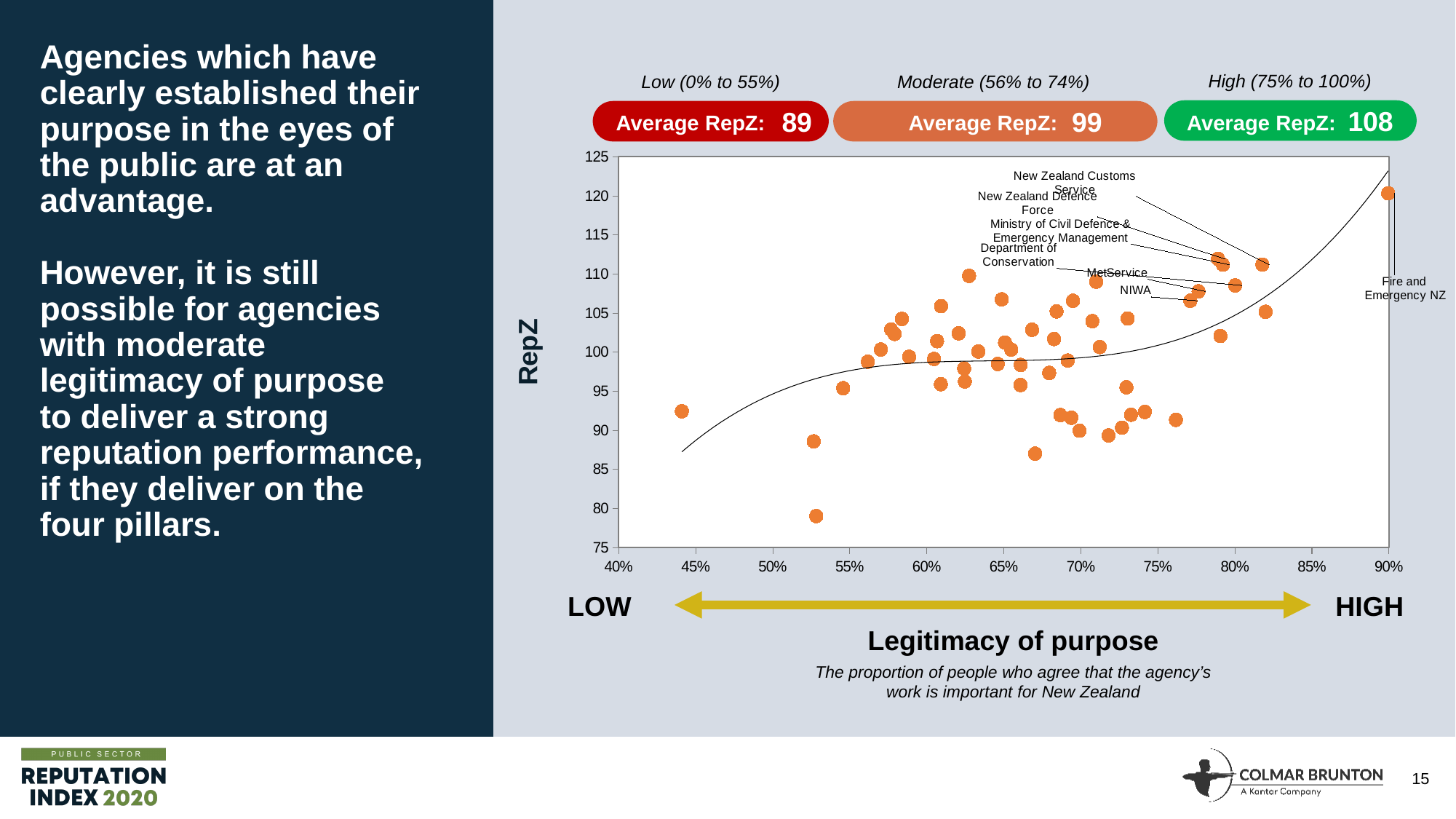
What kind of chart is shown on the slide? scatter chart What is the label on the vertical axis of the chart? RepZ Does RepZ generally rise or fall as legitimacy of purpose increases along the x axis? rise Which is larger, the Average RepZ of the Moderate band or the Low band? Moderate band What is the difference between the Average RepZ of the High band and the Low band? 19 Which legitimacy band has the highest Average RepZ? High (75% to 100%) What is the Average RepZ for the Moderate (56% to 74%) legitimacy band? 99 What is the Average RepZ for the High (75% to 100%) legitimacy band? 108 Is the RepZ value for Fire and Emergency NZ greater or less than 115? greater Which labelled agency has the highest RepZ on the chart? Fire and Emergency NZ Which legitimacy band has the lowest Average RepZ? Low (0% to 55%) What is the Average RepZ for the Low (0% to 55%) legitimacy band? 89